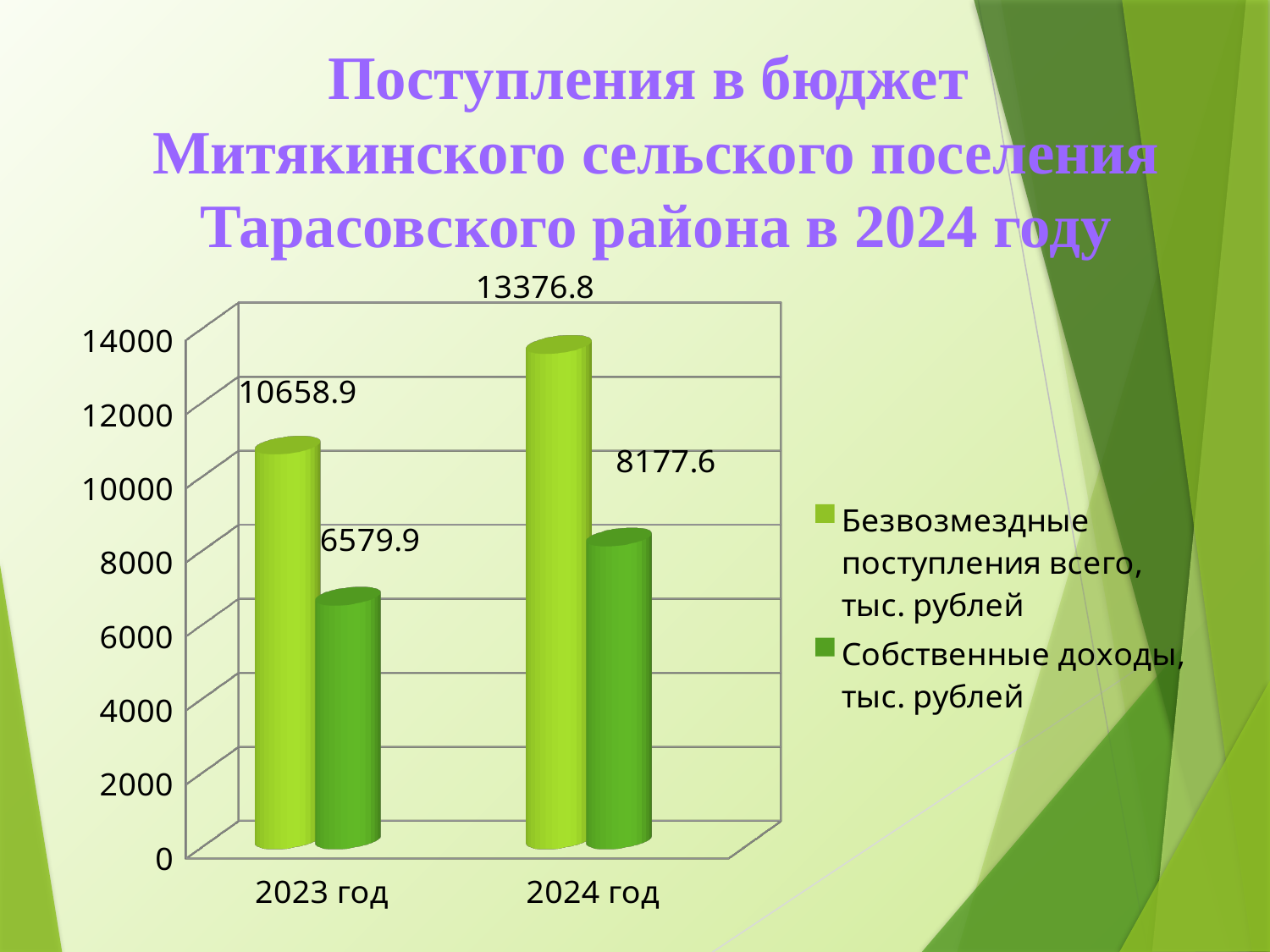
What is the difference between Безвозмездные поступления всего and Собственные доходы in 2024 год? 5199.2 What is the value of Собственные доходы for 2023 год? 6579.9 Which bar on the chart has the highest value? Безвозмездные поступления всего, 2024 год Do the values of Собственные доходы rise or fall from 2023 год to 2024 год? Rise Which is larger in 2023 год: Безвозмездные поступления всего or Собственные доходы? Безвозмездные поступления всего Which bar on the chart has the lowest value? Собственные доходы, 2023 год What kind of chart is shown on the slide? Bar chart What is the value of Собственные доходы for 2024 год? 8177.6 What is the value of Безвозмездные поступления всего for 2023 год? 10658.9 How many series does the legend list? 2 What is the value of Безвозмездные поступления всего for 2024 год? 13376.8 By how much did Безвозмездные поступления всего increase from 2023 год to 2024 год? 2717.9